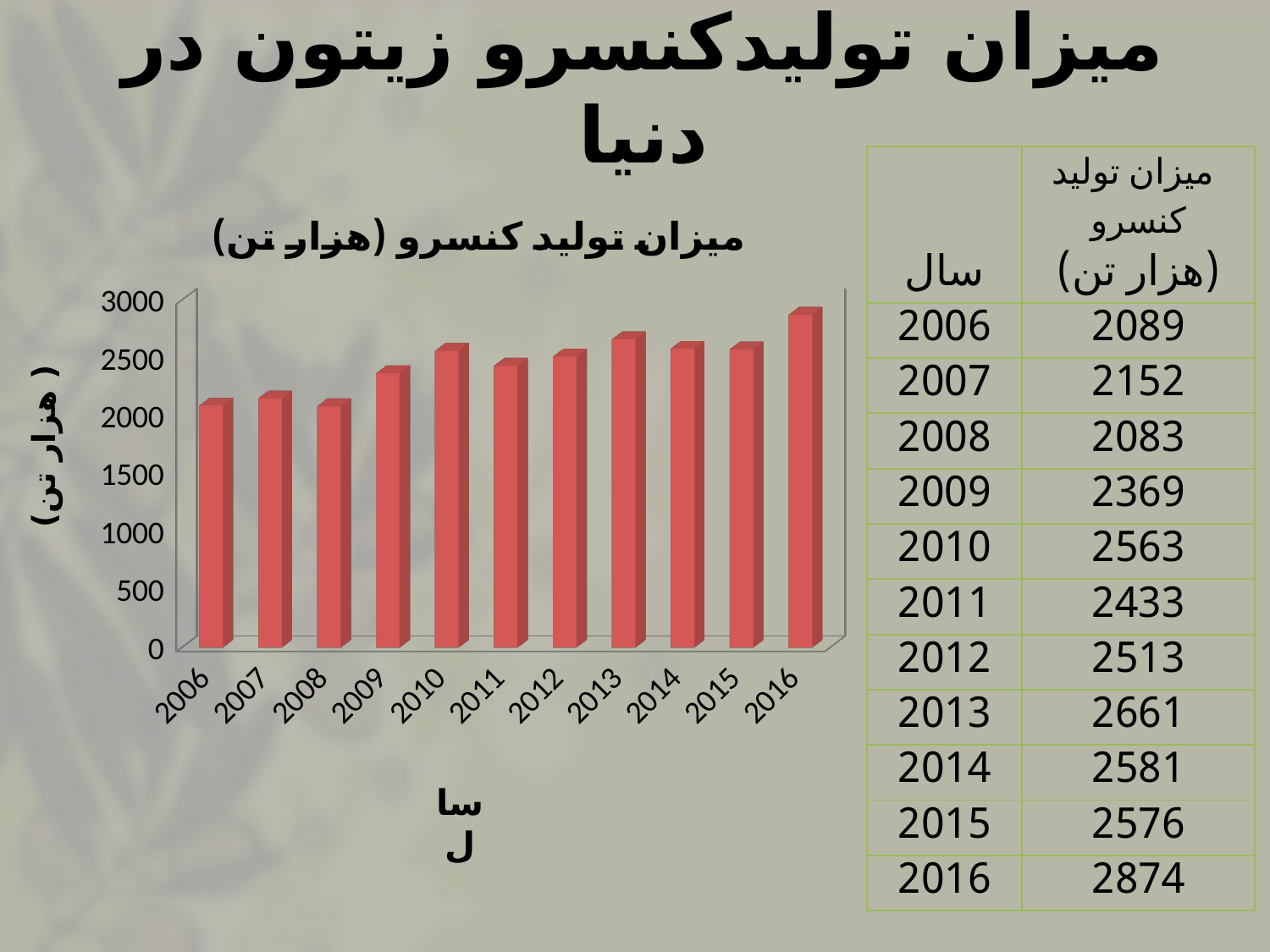
According to the table on the slide, what is the production value for 2013? 2661 Using the values in the table, what is the difference between the 2016 value and the 2006 value? 785 Is the value for 2006 greater or less than 2500? less Which year has the lowest bar in the chart? 2008 Overall, do the bars rise or fall from 2006 to 2016? rise How many years are plotted on the x axis of the chart? 11 Is the value for 2010 greater or less than 2500? greater Which is larger, the value for 2013 or the value for 2011? 2013 According to the table on the slide, what is the production value for 2016? 2874 What kind of chart is shown on the slide? bar chart Which year has the highest bar in the chart? 2016 According to the table on the slide, what is the production value for 2009? 2369